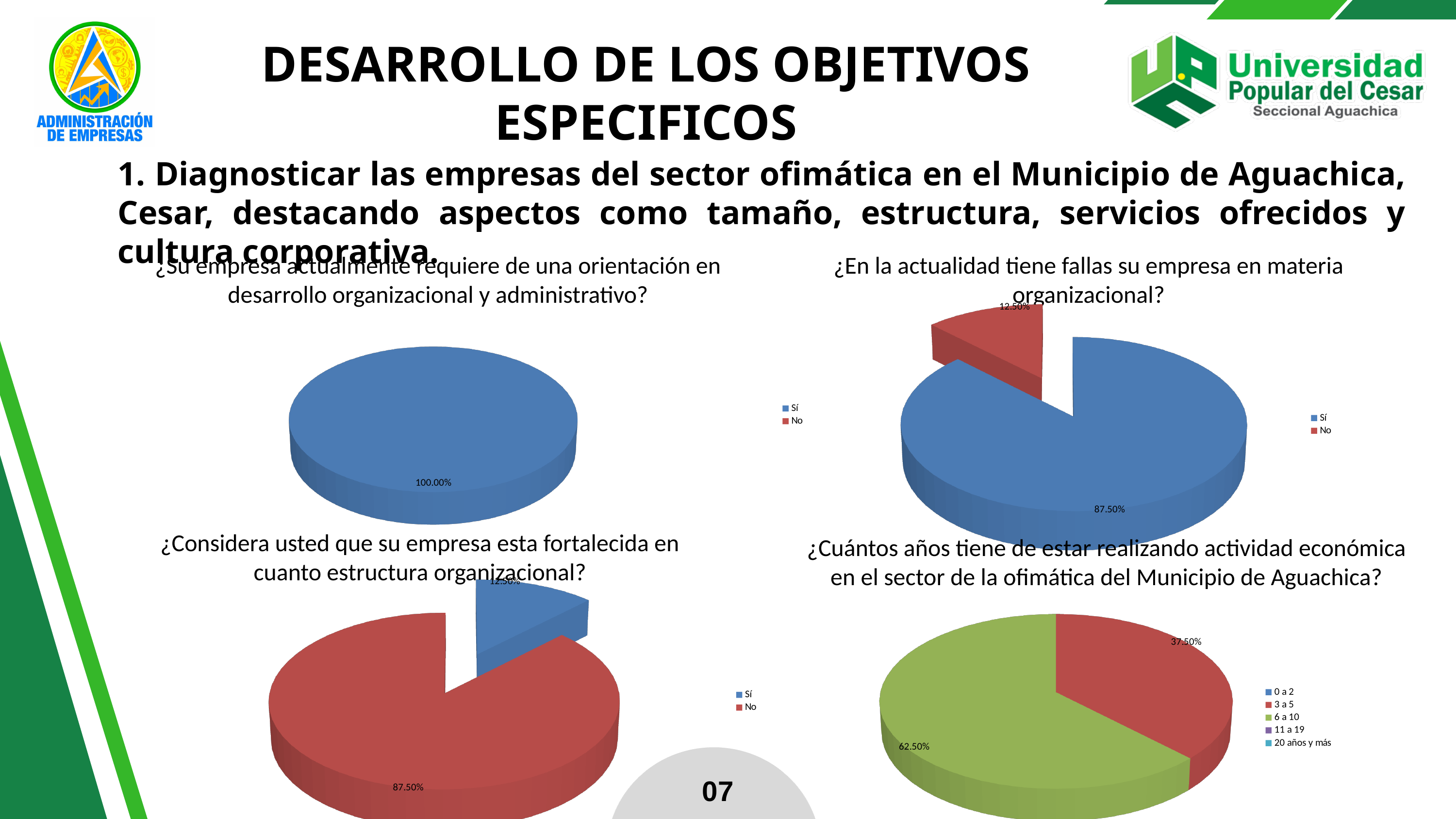
In the bottom-left chart (¿Considera usted que su empresa esta fortalecida en cuanto estructura organizacional?), what percentage is shown for No? 87.50% What kind of chart is the top-left chart about whether the company requires orientation in organizational development? Pie chart In the bottom-left chart about organizational structure strength, what is the difference between the No share and the Sí share? 75.00% In the bottom-left chart (¿Considera usted que su empresa esta fortalecida en cuanto estructura organizacional?), what percentage is shown for Sí? 12.50% In the bottom-right chart (¿Cuántos años tiene de estar realizando actividad económica...?), what percentage is shown for 3 a 5? 37.50% In the bottom-right chart about years of economic activity, which is larger: the share for 3 a 5 or the share for 6 a 10? 6 a 10 In the top-right chart (¿En la actualidad tiene fallas su empresa en materia organizacional?), what percentage is shown for No? 12.50% In the top-right chart about organizational failures, which answer has the largest share? Sí In the bottom-right chart (¿Cuántos años tiene de estar realizando actividad económica...?), what percentage is shown for 6 a 10? 62.50% In the top-left chart (¿Su empresa actualmente requiere de una orientación en desarrollo organizacional y administrativo?), what percentage is shown for Sí? 100.00% In the top-right chart (¿En la actualidad tiene fallas su empresa en materia organizacional?), what percentage is shown for Sí? 87.50% How many entries does the legend of the bottom-right chart about years of economic activity list? 5